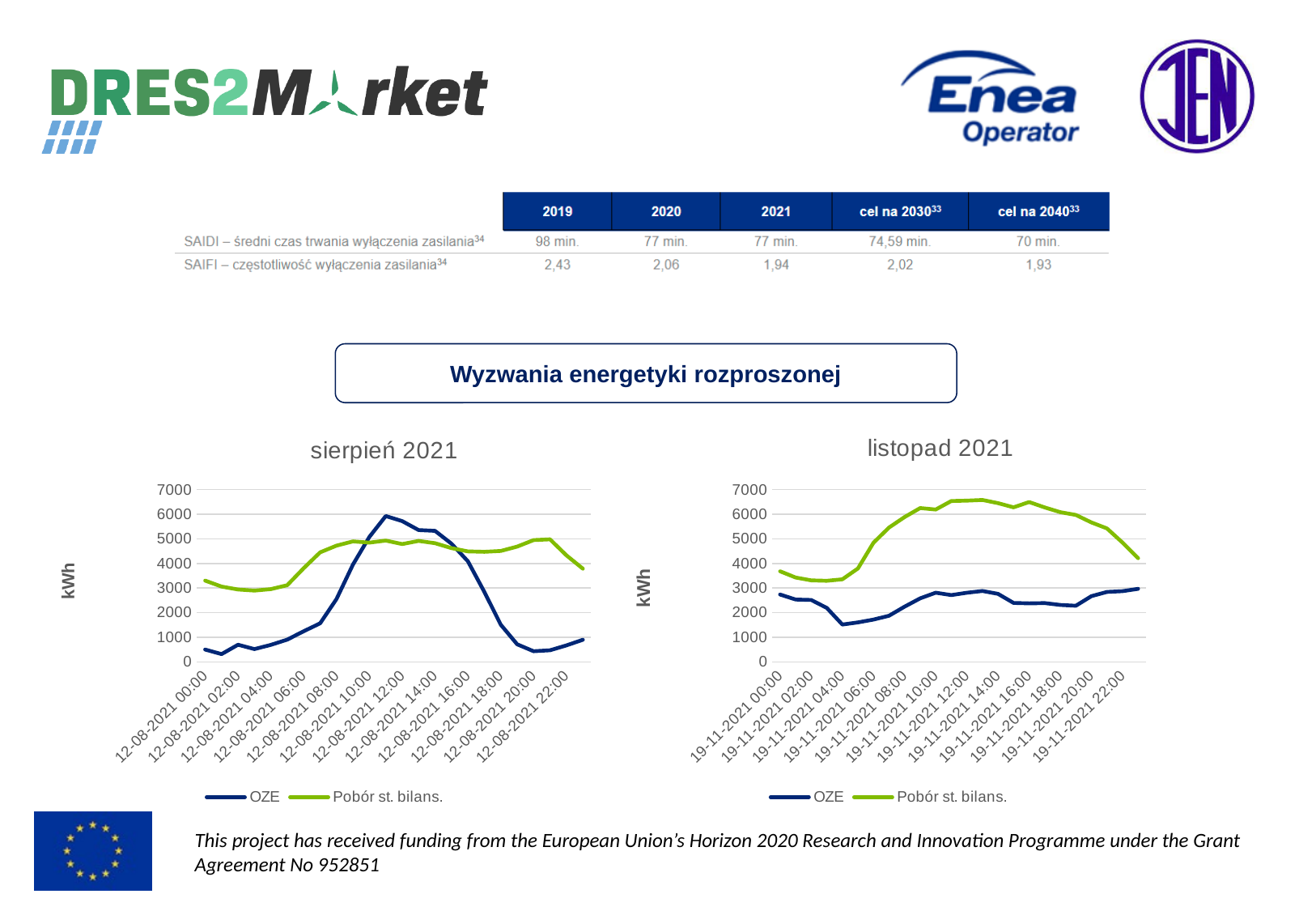
In the 'sierpień 2021' chart, which series has the larger value at 12-08-2021 12:00, OZE or 'Pobór st. bilans.'? OZE In the 'sierpień 2021' chart, is the OZE value at 12-08-2021 00:00 greater or less than 1000? less In the 'sierpień 2021' chart, is the peak value of the OZE series greater or less than 5000? greater In the 'listopad 2021' chart, does the OZE series rise or fall between 19-11-2021 00:00 and 19-11-2021 04:00? fall What is the y-axis label of the 'sierpień 2021' chart? kWh In the 'listopad 2021' chart, is the OZE value at 19-11-2021 00:00 greater or less than 2000? greater What kind of chart is the 'sierpień 2021' chart? line chart In the 'listopad 2021' chart, which series has the larger value at 19-11-2021 12:00, OZE or 'Pobór st. bilans.'? Pobór st. bilans. How many series does the legend of the 'listopad 2021' chart list? 2